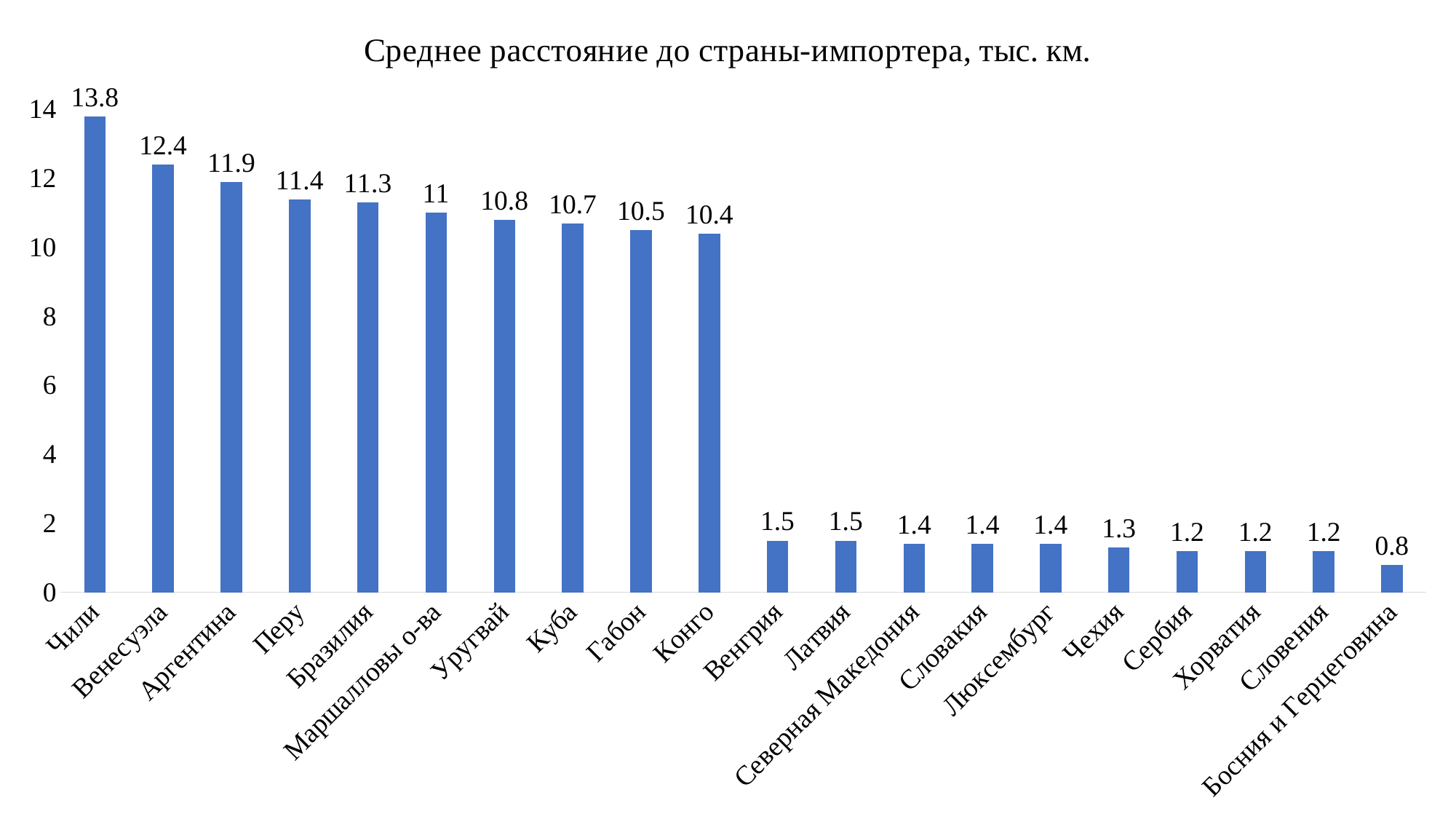
What is the value for Чехия? 1.3 Is the value for Габон greater or less than 10? greater What is the difference between the values for Конго and Венгрия? 8.9 Which is larger, the value for Аргентина or the value for Перу? Аргентина What is the value for Чили? 13.8 Which country has the highest value? Чили How many countries are shown on the chart? 20 What is the value for Уругвай? 10.8 Which country has the lowest value? Босния и Герцеговина What is the title of the chart? Среднее расстояние до страны-импортера, тыс. км. What kind of chart is this? bar chart What is the difference between the values for Чили and Венесуэла? 1.4